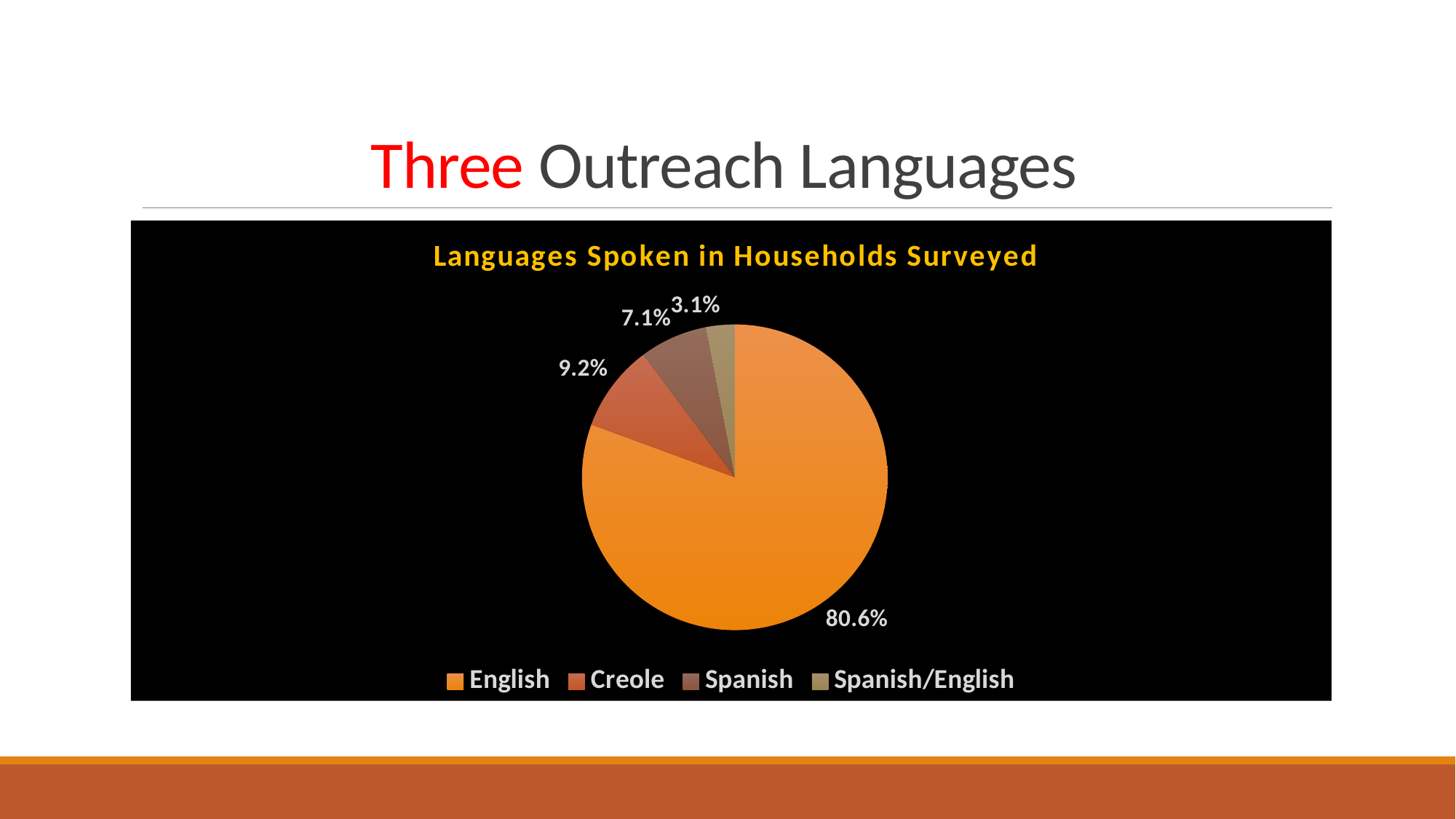
What is the difference in percentage points between the English share and the Creole share? 71.4 What type of chart is shown on the slide? pie chart Which language has the smallest share of the pie? Spanish/English What is the title of the chart? Languages Spoken in Households Surveyed Which language has the largest share of the pie? English What percentage of households surveyed speak Creole? 9.2% What percentage of households surveyed speak Spanish/English? 3.1% How many categories does the legend list? 4 What percentage of households surveyed speak English? 80.6% What is the difference in percentage points between the Spanish share and the Spanish/English share? 4.0 Which is larger, the share for Creole or the share for Spanish? Creole What percentage of households surveyed speak Spanish? 7.1%